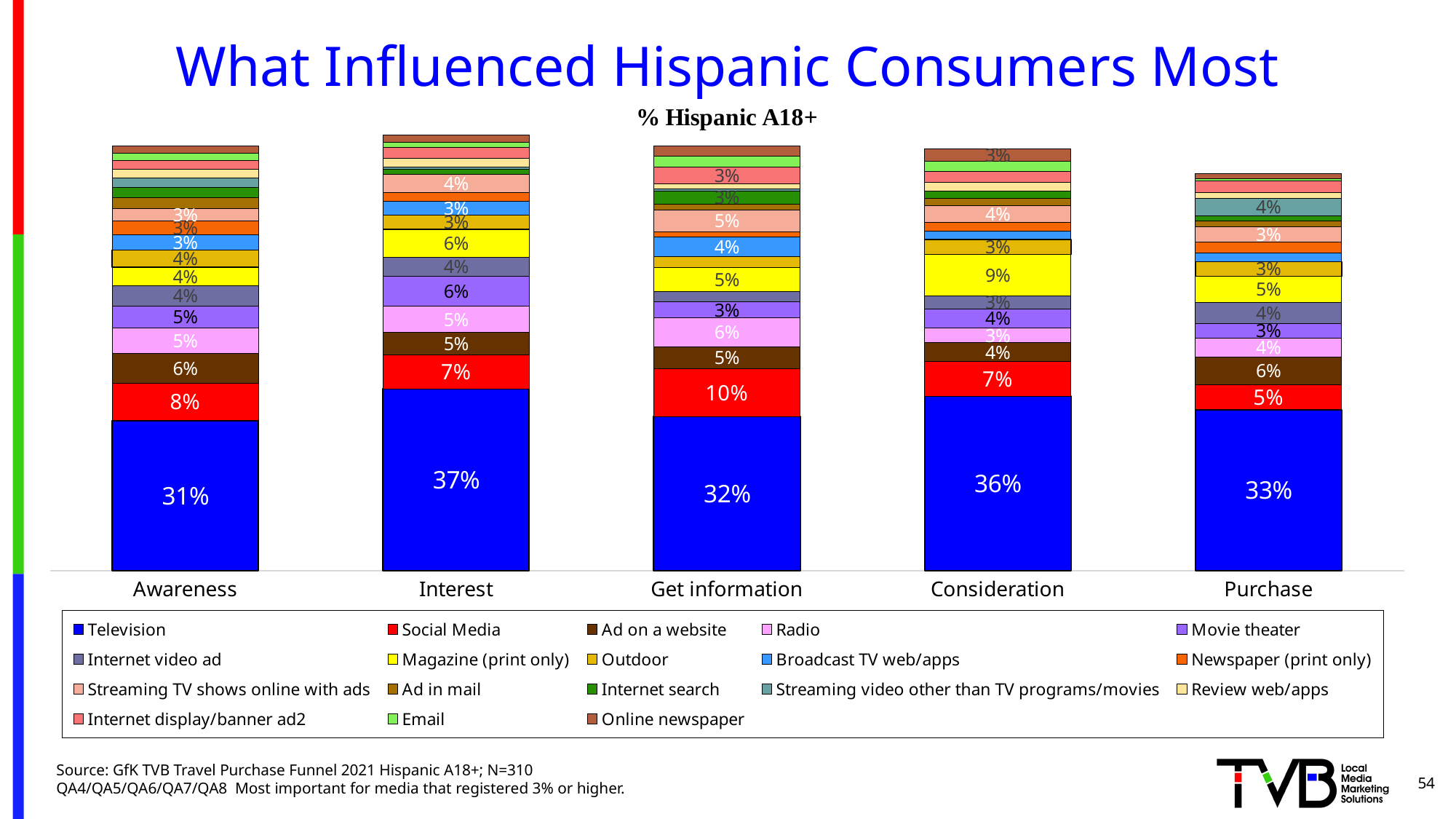
What is the difference between the Television values for Interest and Awareness? 6 percentage points How many stages (categories) are shown on the x axis? 5 Which stage has the lowest Television value? Awareness What is the Social Media value for the Get information stage? 10% Which stage has the larger Social Media value, Awareness or Purchase? Awareness How many series does the legend list? 18 What is the Ad on a website value for the Purchase stage? 6% What is the Magazine (print only) value for the Consideration stage? 9% What kind of chart is shown on the slide? Stacked bar chart Which stage has the highest Television value? Interest What is the subtitle shown above the chart? % Hispanic A18+ What is the Television value for the Interest stage? 37%